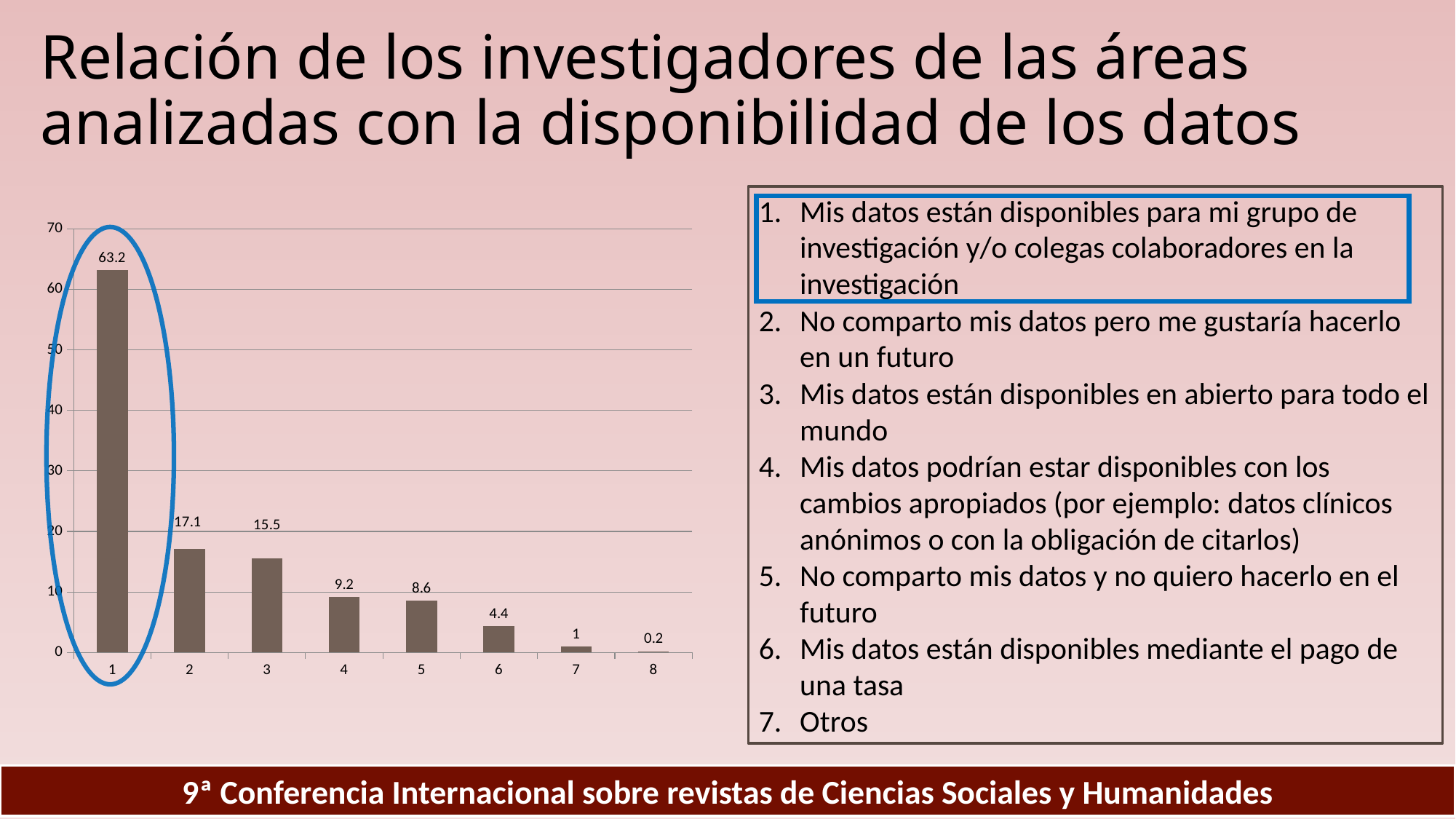
How many categories are shown on the x axis? 8 What is the value for category 8? 0.2 Which category has the lowest value? 8 What is the value for category 1? 63.2 Do the values rise or fall from category 1 to category 8? Fall What is the value for category 6? 4.4 What is the difference between the values for category 2 and category 3? 1.6 What is the value for category 3? 15.5 Which is larger, the value for category 2 or the value for category 4? Category 2 Which category has the highest value? 1 What kind of chart is shown on the slide? Bar chart What is the difference between the values for category 4 and category 5? 0.6